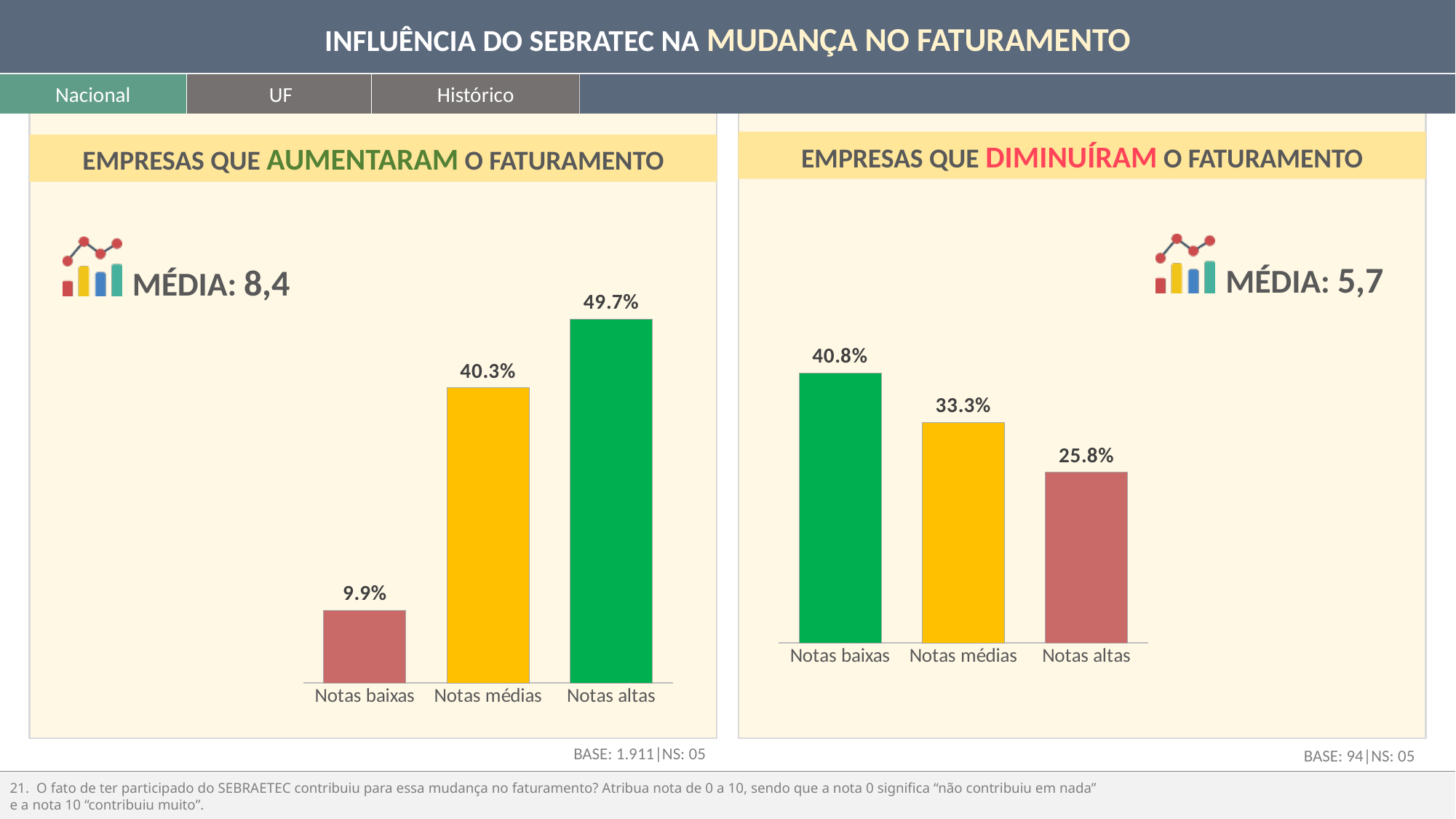
How many categories are shown in the chart 'EMPRESAS QUE AUMENTARAM O FATURAMENTO'? 3 What type of chart is 'EMPRESAS QUE DIMINUÍRAM O FATURAMENTO'? Bar chart In the chart 'EMPRESAS QUE AUMENTARAM O FATURAMENTO', what is the difference between Notas altas and Notas baixas? 39.8% In the chart 'EMPRESAS QUE DIMINUÍRAM O FATURAMENTO', what is the value for Notas médias? 33.3% In the chart 'EMPRESAS QUE DIMINUÍRAM O FATURAMENTO', which is larger: Notas baixas or Notas altas? Notas baixas In the chart 'EMPRESAS QUE DIMINUÍRAM O FATURAMENTO', what is the difference between Notas baixas and Notas médias? 7.5% In the chart 'EMPRESAS QUE DIMINUÍRAM O FATURAMENTO', do the values rise or fall from Notas baixas to Notas altas? Fall In the chart 'EMPRESAS QUE DIMINUÍRAM O FATURAMENTO', what is the value for Notas altas? 25.8% In the chart 'EMPRESAS QUE AUMENTARAM O FATURAMENTO', what is the value for Notas altas? 49.7% In the chart 'EMPRESAS QUE AUMENTARAM O FATURAMENTO', which category has the highest value? Notas altas In the chart 'EMPRESAS QUE DIMINUÍRAM O FATURAMENTO', which category has the lowest value? Notas altas In the chart 'EMPRESAS QUE AUMENTARAM O FATURAMENTO', what is the value for Notas baixas? 9.9%